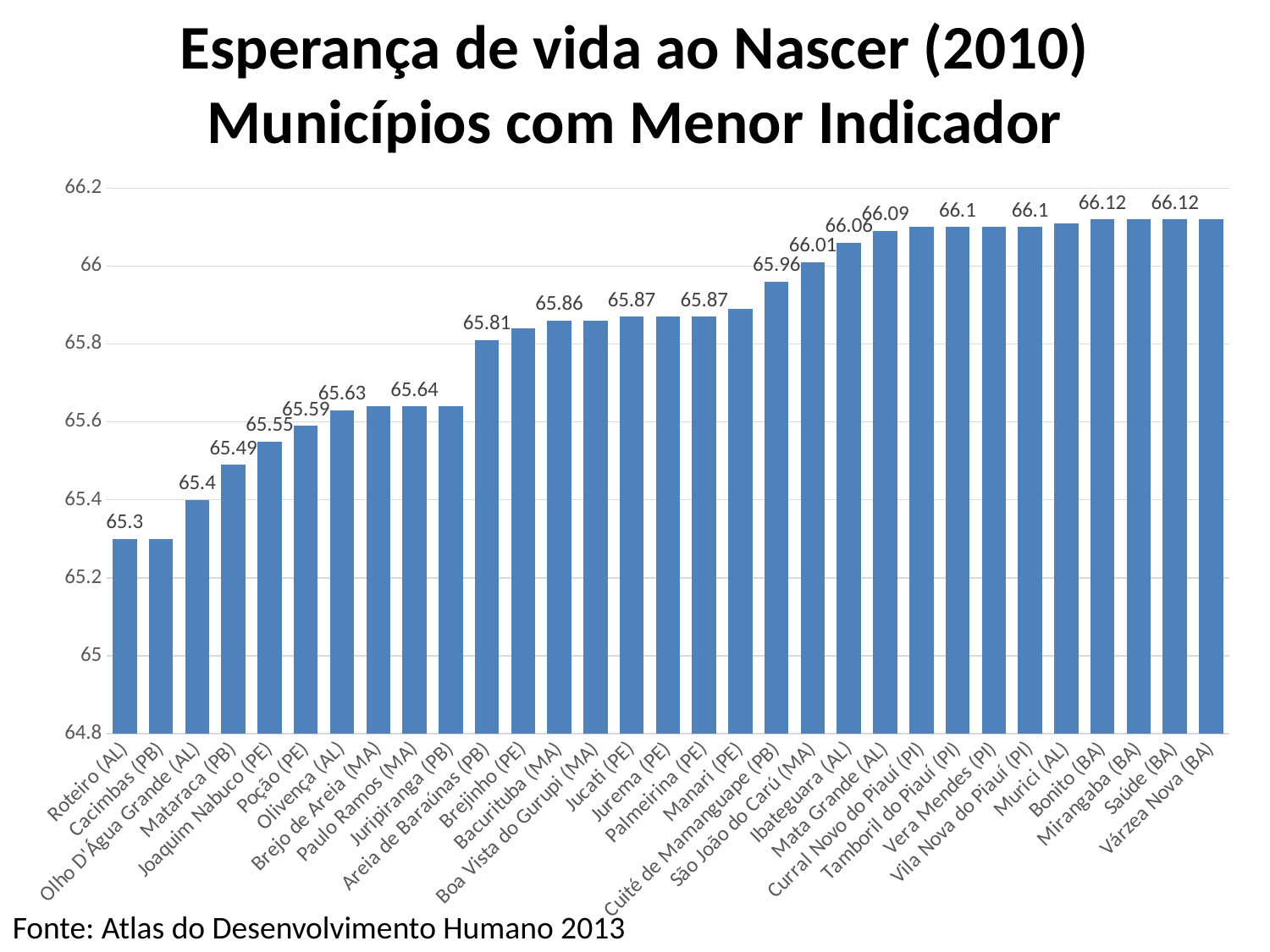
Which has the larger value, Mata Grande (AL) or Roteiro (AL)? Mata Grande (AL) How many municipalities are shown on the x axis? 31 What value is labelled for Cuité de Mamanguape (PB)? 65.96 What is the difference between the values for Mata Grande (AL) and Roteiro (AL)? 0.79 What value is labelled for Mata Grande (AL)? 66.09 What value is labelled for Areia de Baraúnas (PB)? 65.81 What type of chart is shown on the slide? Bar chart Do the values generally rise or fall from left to right along the x axis? Rise Is the value for Jucati (PE) greater or less than 66? less Is the value for Várzea Nova (BA) greater or less than 66? greater What is the life expectancy value shown for Roteiro (AL)? 65.3 What source is cited below the chart? Atlas do Desenvolvimento Humano 2013